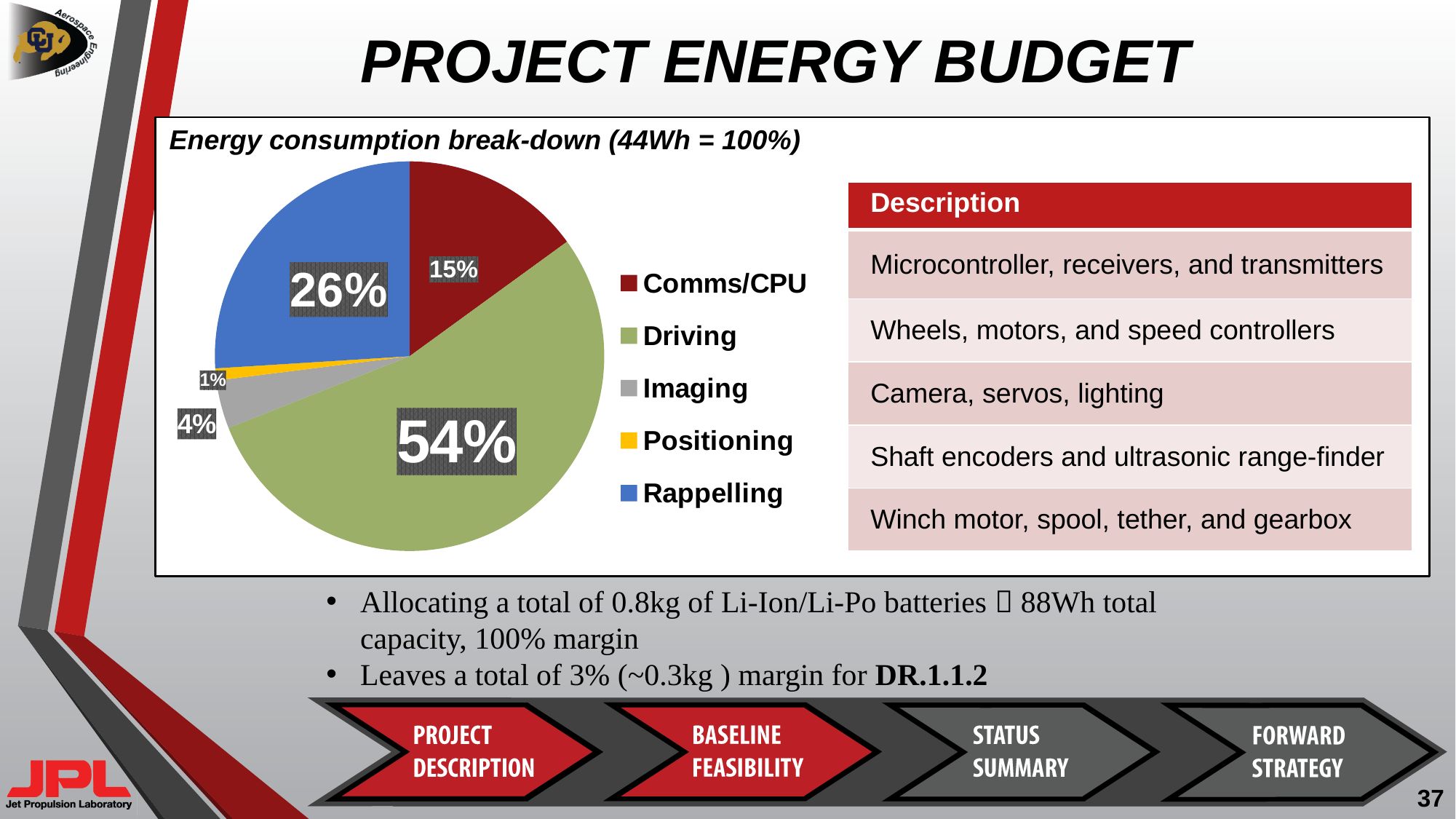
What share of energy consumption does Comms/CPU account for? 15% How many categories does the pie chart have? 5 Which category has the smallest share of the pie? Positioning Which has a larger share, Comms/CPU or Imaging? Comms/CPU What share of energy consumption does Rappelling account for? 26% What share of energy consumption does Driving account for? 54% What is the title of the chart? Energy consumption break-down (44Wh = 100%) What is the difference in percentage points between Driving and Rappelling? 28 What share of energy consumption does Imaging account for? 4% What kind of chart is shown on the slide? pie chart What share of energy consumption does Positioning account for? 1% Which category has the largest share of the pie? Driving